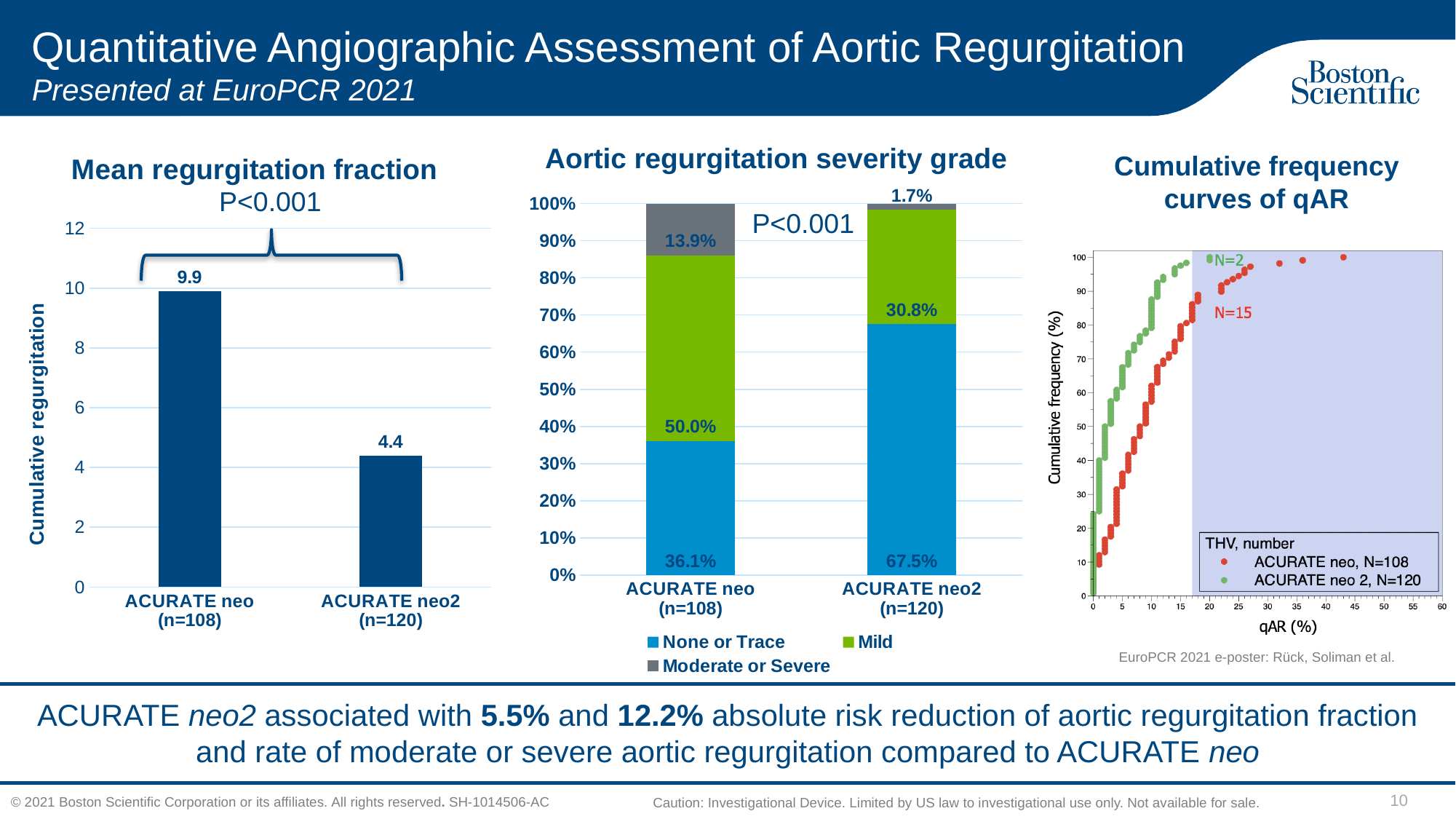
In the 'Aortic regurgitation severity grade' chart, what is the 'Moderate or Severe' share for ACURATE neo (n=108)? 13.9% How many series does the legend of the 'Aortic regurgitation severity grade' chart list? 3 In the 'Aortic regurgitation severity grade' chart, what is the 'None or Trace' share for ACURATE neo2 (n=120)? 67.5% In the 'Aortic regurgitation severity grade' chart, which category has the larger 'None or Trace' share, ACURATE neo or ACURATE neo2? ACURATE neo2 What kind of chart is the 'Mean regurgitation fraction' chart? Bar chart In the 'Aortic regurgitation severity grade' chart, what is the 'Mild' share for ACURATE neo2 (n=120)? 30.8% In the 'Cumulative frequency curves of qAR' chart, what is the label of the x axis? qAR (%) In the 'Mean regurgitation fraction' chart, which category has the higher value? ACURATE neo (n=108) In the 'Mean regurgitation fraction' chart, what is the difference between the ACURATE neo and ACURATE neo2 values? 5.5 In the 'Aortic regurgitation severity grade' chart, what is the difference in the 'Moderate or Severe' share between ACURATE neo and ACURATE neo2? 12.2% In the 'Mean regurgitation fraction' chart, what is the value for ACURATE neo (n=108)? 9.9 In the 'Mean regurgitation fraction' chart, what is the value for ACURATE neo2 (n=120)? 4.4